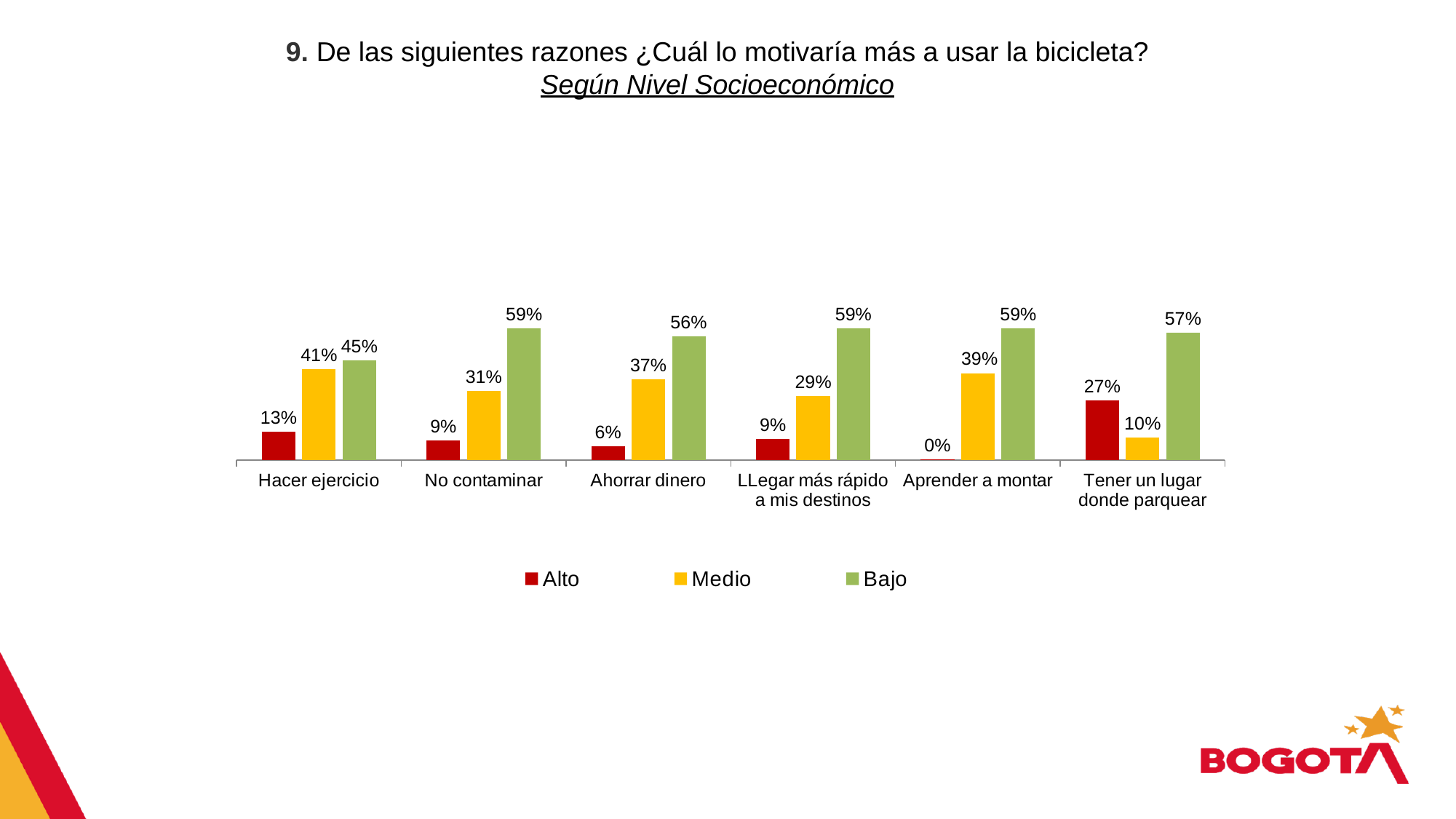
Which category has the lowest value for the Alto series? Aprender a montar Which category has the lowest value for the Medio series? Tener un lugar donde parquear Which is larger for Hacer ejercicio: the Medio value or the Bajo value? Bajo What kind of chart is shown on the slide? Bar chart Which colour represents the Bajo series in the legend? Green What is the value for Alto in the Tener un lugar donde parquear category? 27% How many series does the legend list? 3 What is the value for Medio in the Hacer ejercicio category? 41% Which category has the highest value for the Alto series? Tener un lugar donde parquear What is the value for Bajo in the Ahorrar dinero category? 56% What is the difference between the Bajo and Alto values for No contaminar? 50% How many categories are shown on the x axis? 6